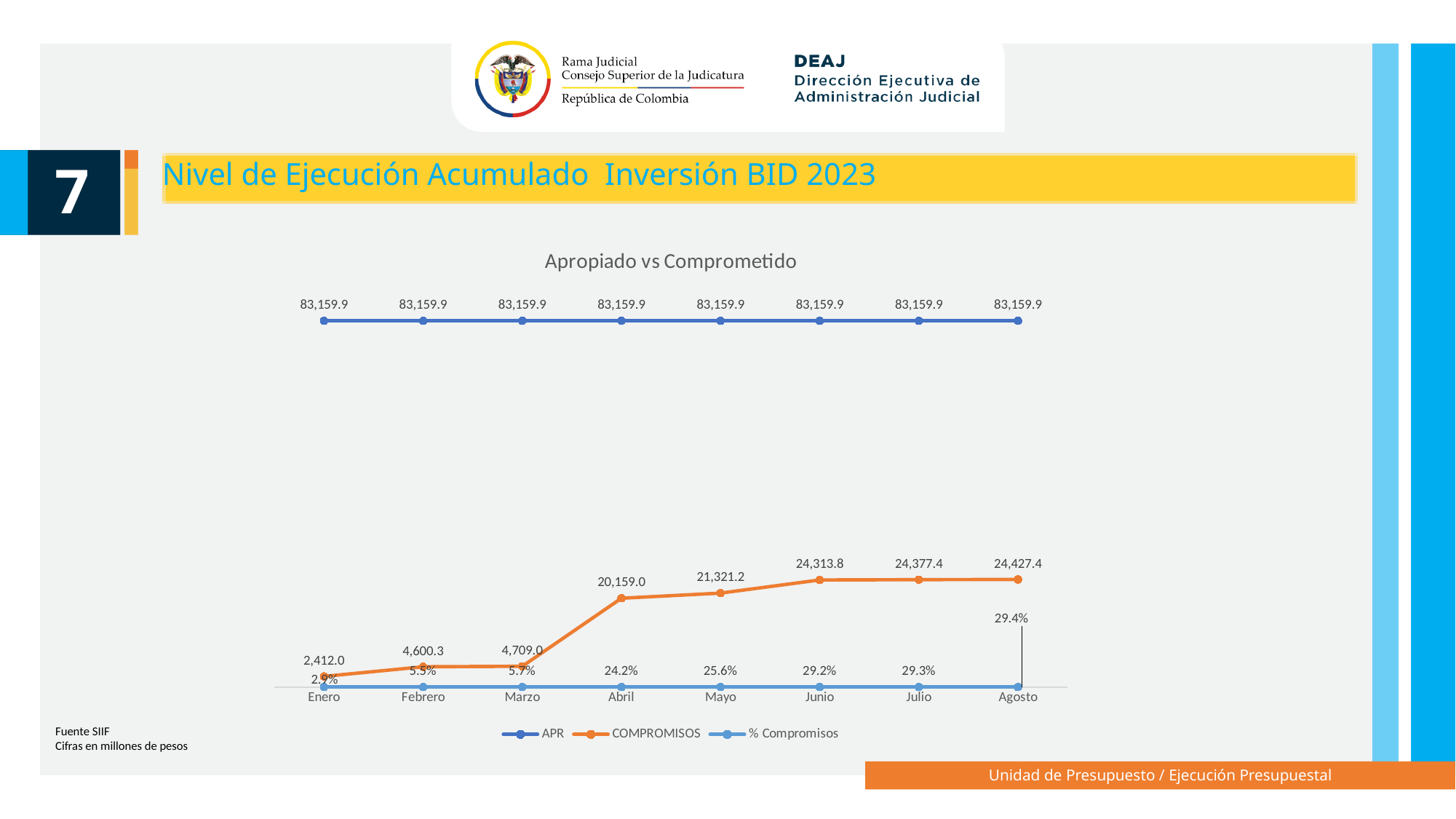
In which month is the COMPROMISOS value highest? Agosto What kind of chart is shown on the slide? line chart What is the difference between the COMPROMISOS values for Abril and Marzo? 15,450.0 What is the title of the chart? Apropiado vs Comprometido Does the COMPROMISOS series rise or fall from Enero to Agosto? rise How many series does the chart legend list? 3 What is the APR value for Junio? 83,159.9 What is the COMPROMISOS value for Abril? 20,159.0 In which month is the COMPROMISOS value lowest? Enero How many months are plotted along the x axis of the chart? 8 Which is larger, the COMPROMISOS value for Febrero or for Marzo? Marzo What is the % Compromisos value for Agosto? 29.4%